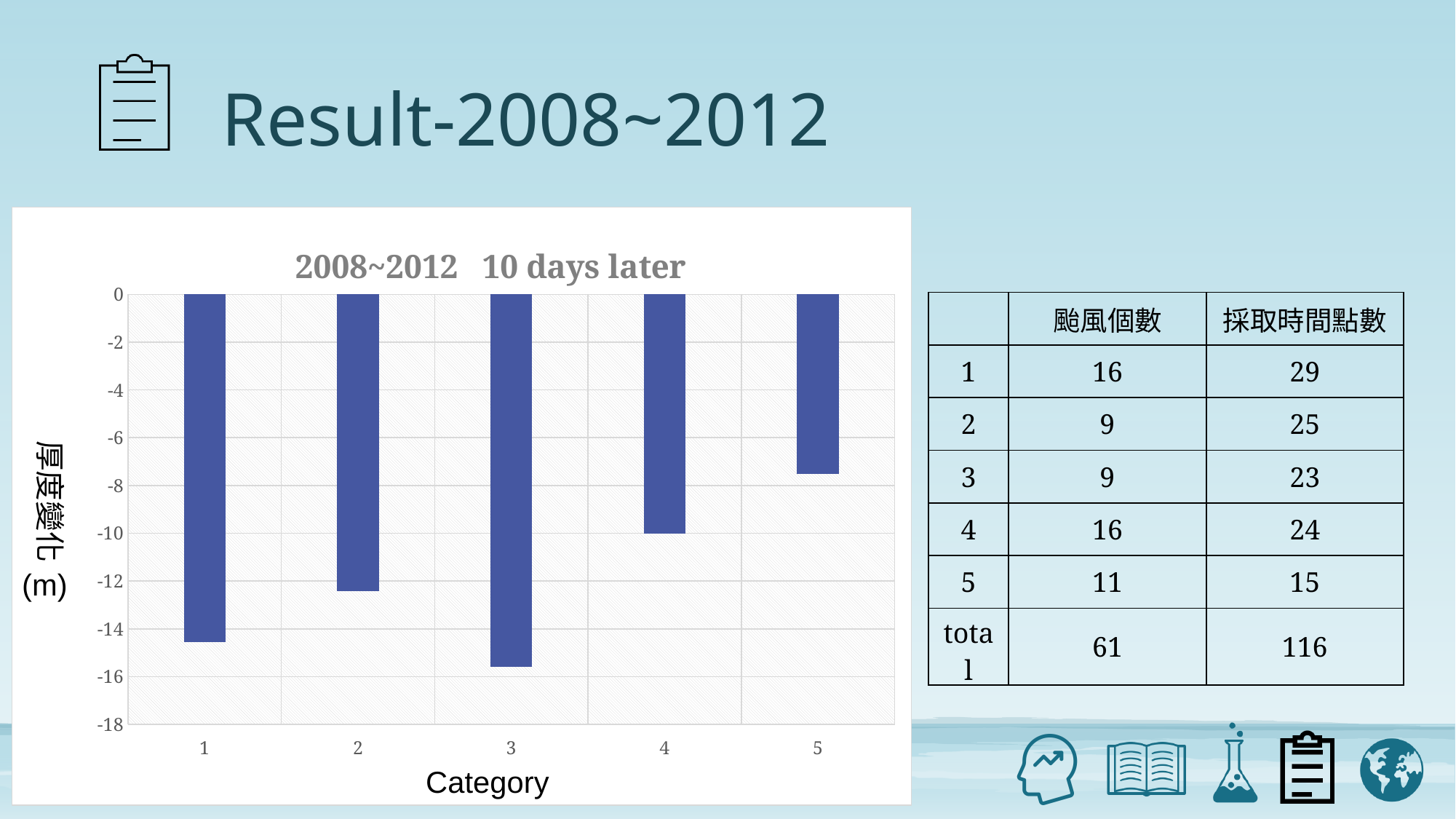
What is the title of the chart? 2008~2012 10 days later Which category has the lowest (most negative) value in the chart? 3 What kind of chart is shown on the slide? bar chart Which has the larger (less negative) value, category 2 or category 4? 4 Is the value for category 2 greater or less than -12? less Is the value for category 5 greater or less than -8? greater How many categories are plotted on the x axis of the chart? 5 Is the value for category 3 greater or less than -14? less Which has the larger (less negative) value, category 1 or category 5? 5 What is the label of the x axis of the chart? Category Which category has the highest value (closest to zero) in the chart? 5